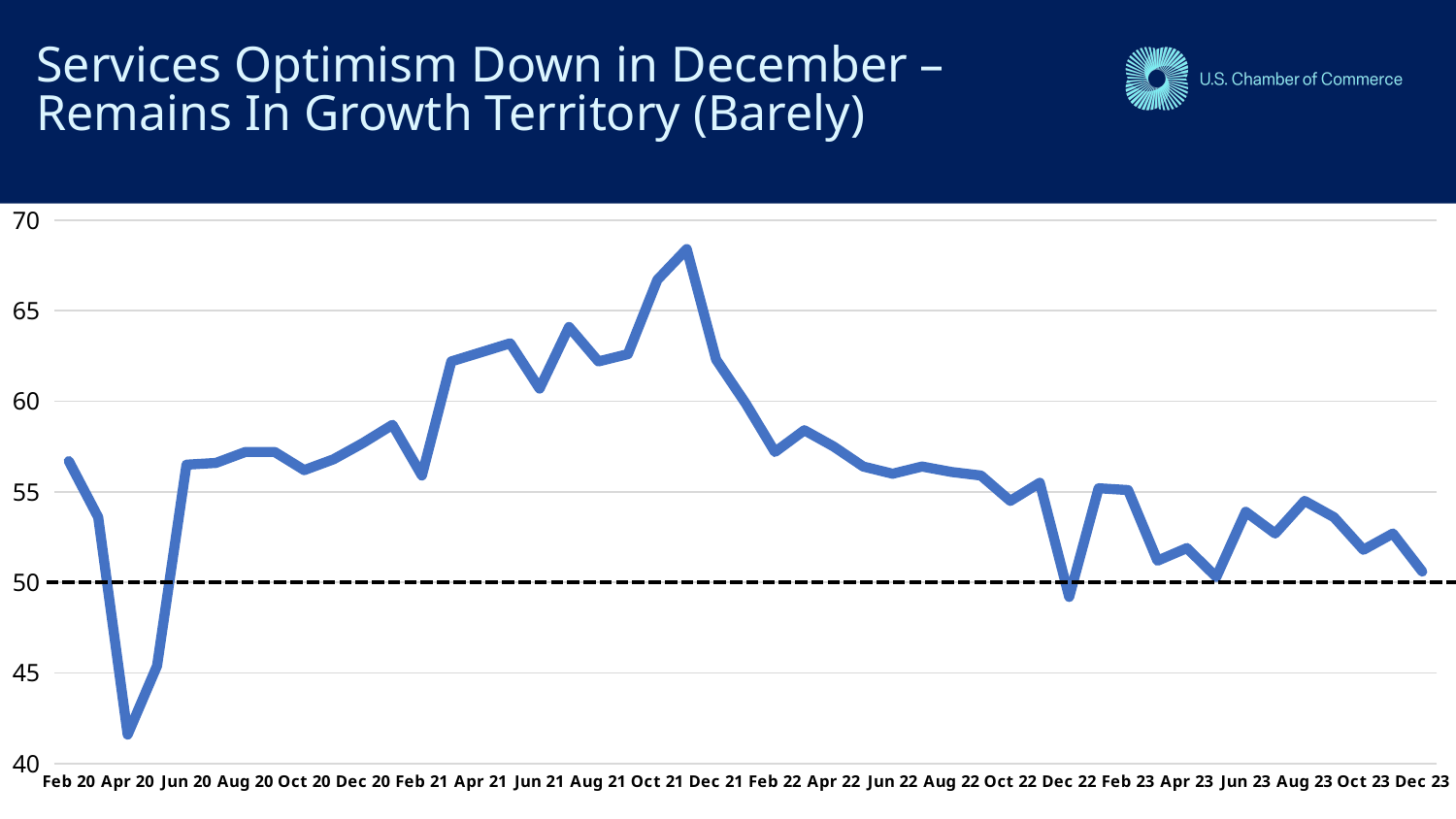
What kind of chart is shown on the slide? Line chart Is the value for Apr 20 greater or less than 45? less At what value on the y-axis is the horizontal dashed line drawn? 50 Does the line rise or fall between Feb 20 and Apr 20? fall What is the title of the slide's chart? Services Optimism Down in December – Remains In Growth Territory (Barely) Is the value for Feb 20 greater or less than 55? greater Is the value for Apr 21 greater or less than 60? greater How many month labels are shown along the x-axis? 24 Which labeled month has the lowest value on the chart? Apr 20 Is the value for Apr 21 larger or smaller than the value for Apr 20? larger